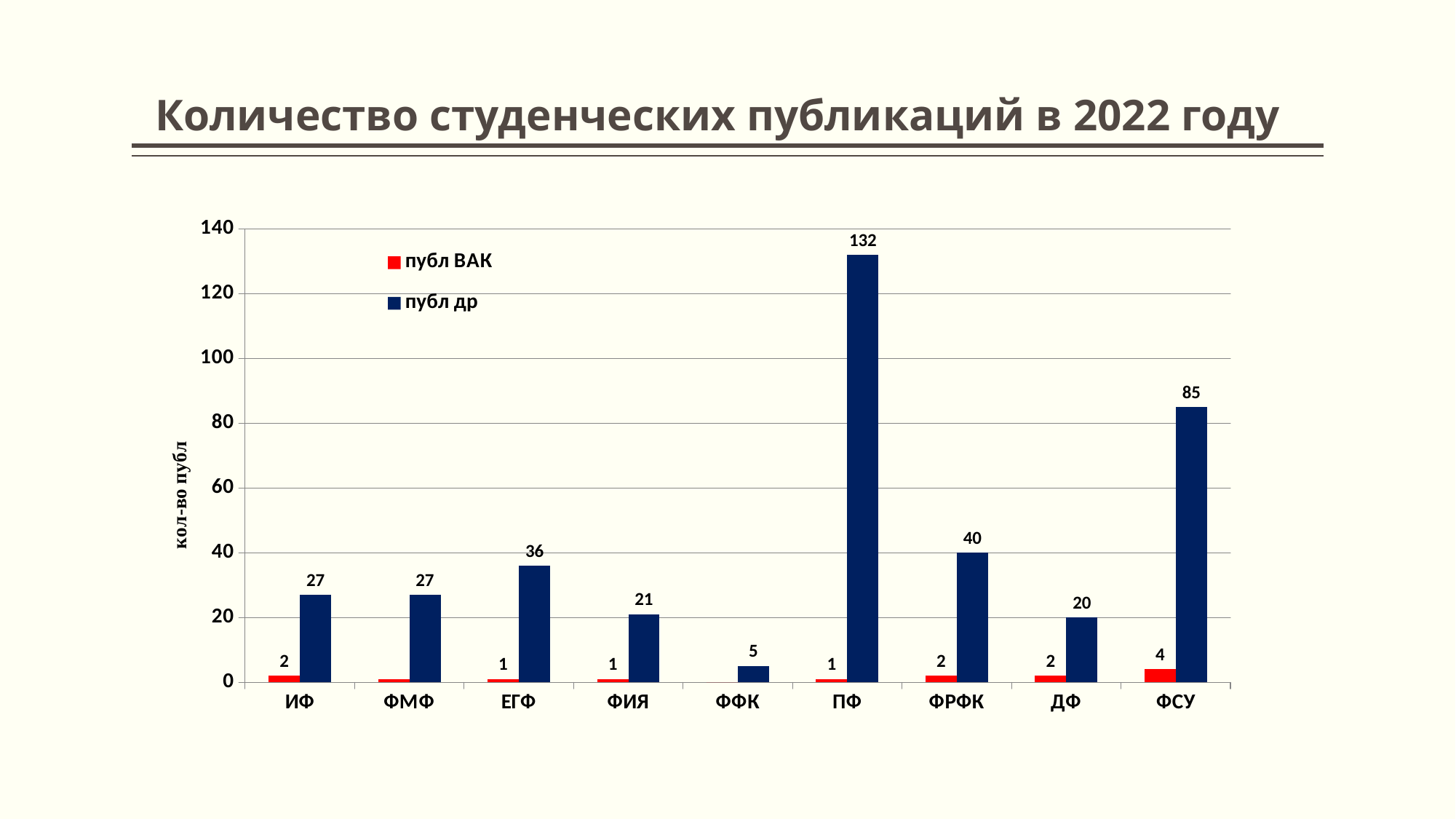
How many categories are shown on the x axis? 9 Which category has the lowest value of публ др? ФФК What type of chart is shown on the slide? bar chart Which category has the highest value of публ др? ПФ How many series does the legend list? 2 Which is larger: публ др for ЕГФ or публ др for ФИЯ? ЕГФ Is the value of публ др for ФСУ greater or less than 80? greater What is the difference between публ др for ПФ and публ др for ФСУ? 47 What is the title of the chart on the slide? Количество студенческих публикаций в 2022 году What is the value of публ ВАК for ФСУ? 4 What is the value of публ др for ФРФК? 40 What is the value of публ др for ПФ? 132